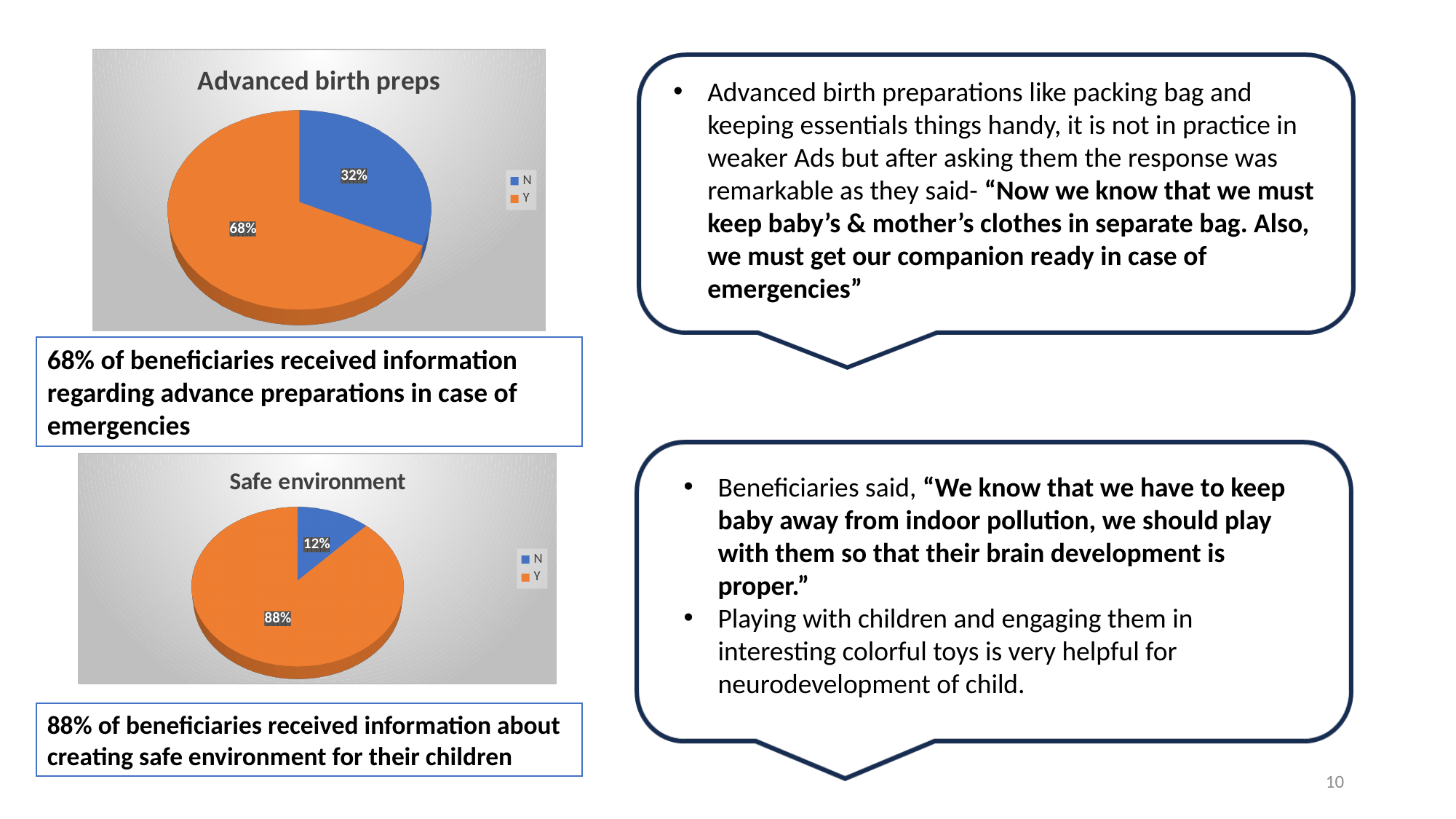
In the 'Safe environment' chart, what is the difference between the Y and N shares? 76% In the 'Advanced birth preps' chart, what is the difference between the Y and N shares? 36% In the 'Advanced birth preps' chart, what share of the pie is labelled N? 32% Which chart has the larger Y share, 'Advanced birth preps' or 'Safe environment'? Safe environment In the 'Safe environment' chart, what colour is the Y slice? Orange What type of chart is the 'Safe environment' chart? Pie chart In the 'Advanced birth preps' chart, which category has the larger slice? Y In the 'Advanced birth preps' chart, what share of the pie is labelled Y? 68% In the 'Safe environment' chart, which category has the smaller slice? N How many categories does the legend of the 'Advanced birth preps' chart list? 2 In the 'Safe environment' chart, what share of the pie is labelled Y? 88%